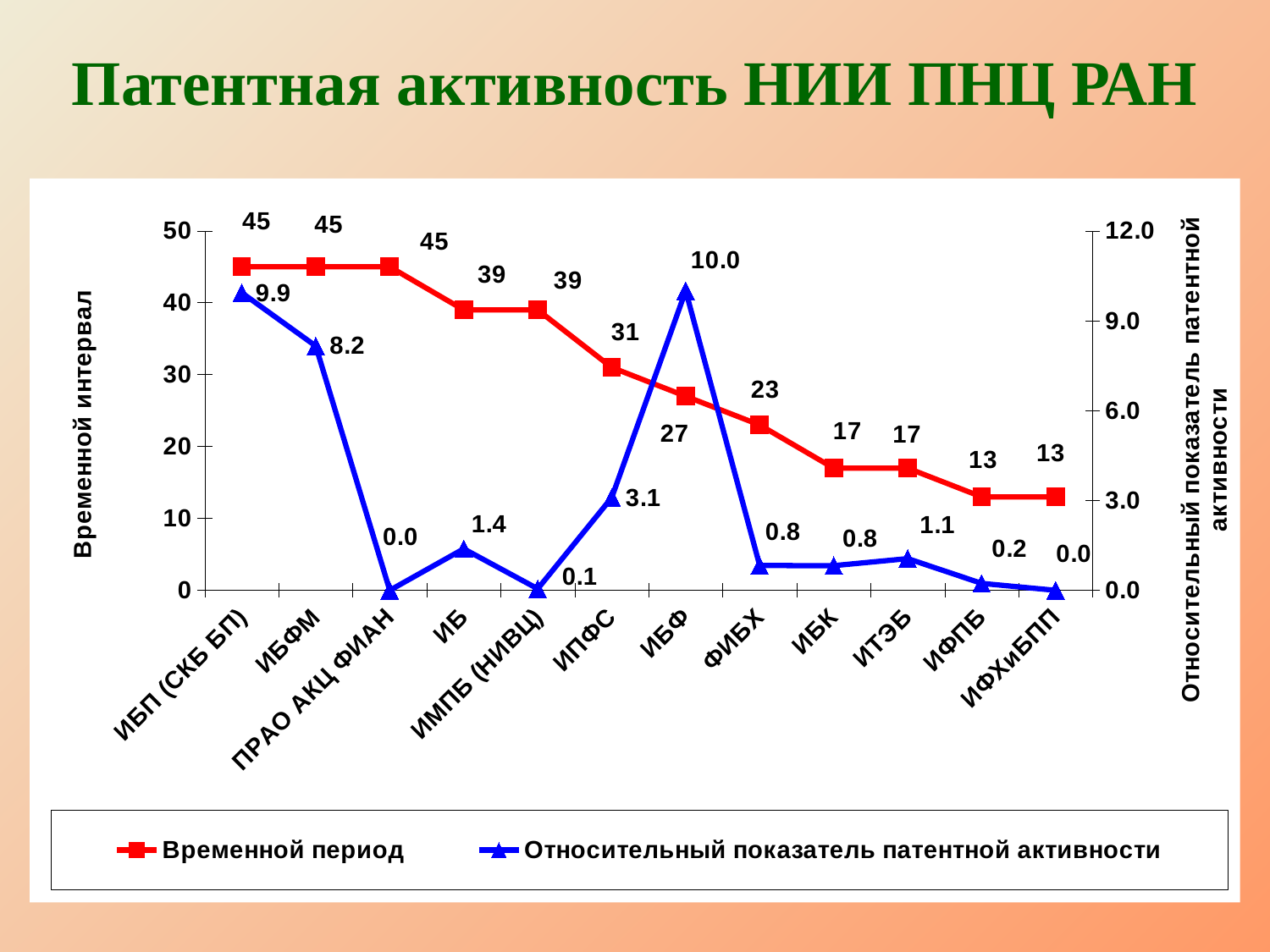
What is the difference between the Временной период values for ИБП (СКБ БП) and ИФХиБПП? 32 Which category has the lowest value in the Временной период series, ИБФ or ФИБХ? ФИБХ Does the Временной период series rise or fall from left to right along the x axis? fall What is the difference between the Относительный показатель патентной активности values for ИБФ and ИПФС? 6.9 How many series does the legend list? 2 What kind of chart is shown on the slide? line chart What is the value of the Временной период series for ИПФС? 31 How many categories are shown on the x axis? 12 What is the value of the Относительный показатель патентной активности series for ИБФМ? 8.2 Is the Относительный показатель патентной активности value for ИБП (СКБ БП) larger or smaller than that for ИТЭБ? larger Which category has the highest value in the Относительный показатель патентной активности series? ИБФ What is the value of the Относительный показатель патентной активности series for ИБФ? 10.0